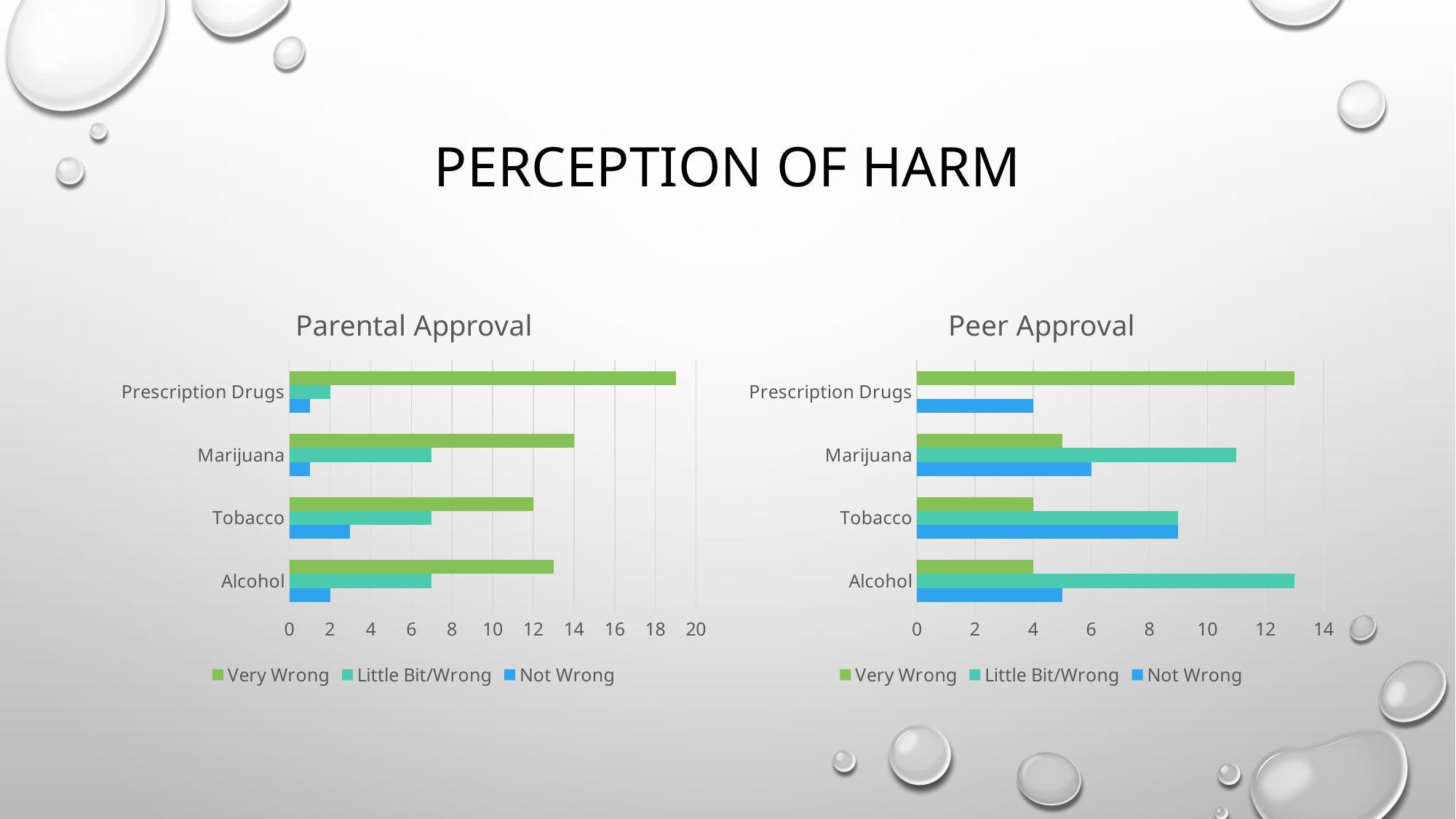
In the Parental Approval chart, is the Very Wrong value for Prescription Drugs greater or less than 18? greater In the Parental Approval chart, what is the Very Wrong value for Tobacco? 12 How many series does the legend of the Peer Approval chart list? 3 In the Peer Approval chart, what is the Not Wrong value for Marijuana? 6 In the Peer Approval chart, which is larger for Alcohol: the Very Wrong value or the Little Bit/Wrong value? Little Bit/Wrong In the Peer Approval chart, which category has the lowest Little Bit/Wrong value? Prescription Drugs How many categories are shown on the Parental Approval chart? 4 In the Parental Approval chart, what is the Very Wrong value for Marijuana? 14 In the Parental Approval chart, which category has the highest Very Wrong value? Prescription Drugs In the Peer Approval chart, what is the Not Wrong value for Prescription Drugs? 4 What kind of chart is the Parental Approval chart? bar chart Which series is shown in blue in the Parental Approval chart's legend? Not Wrong